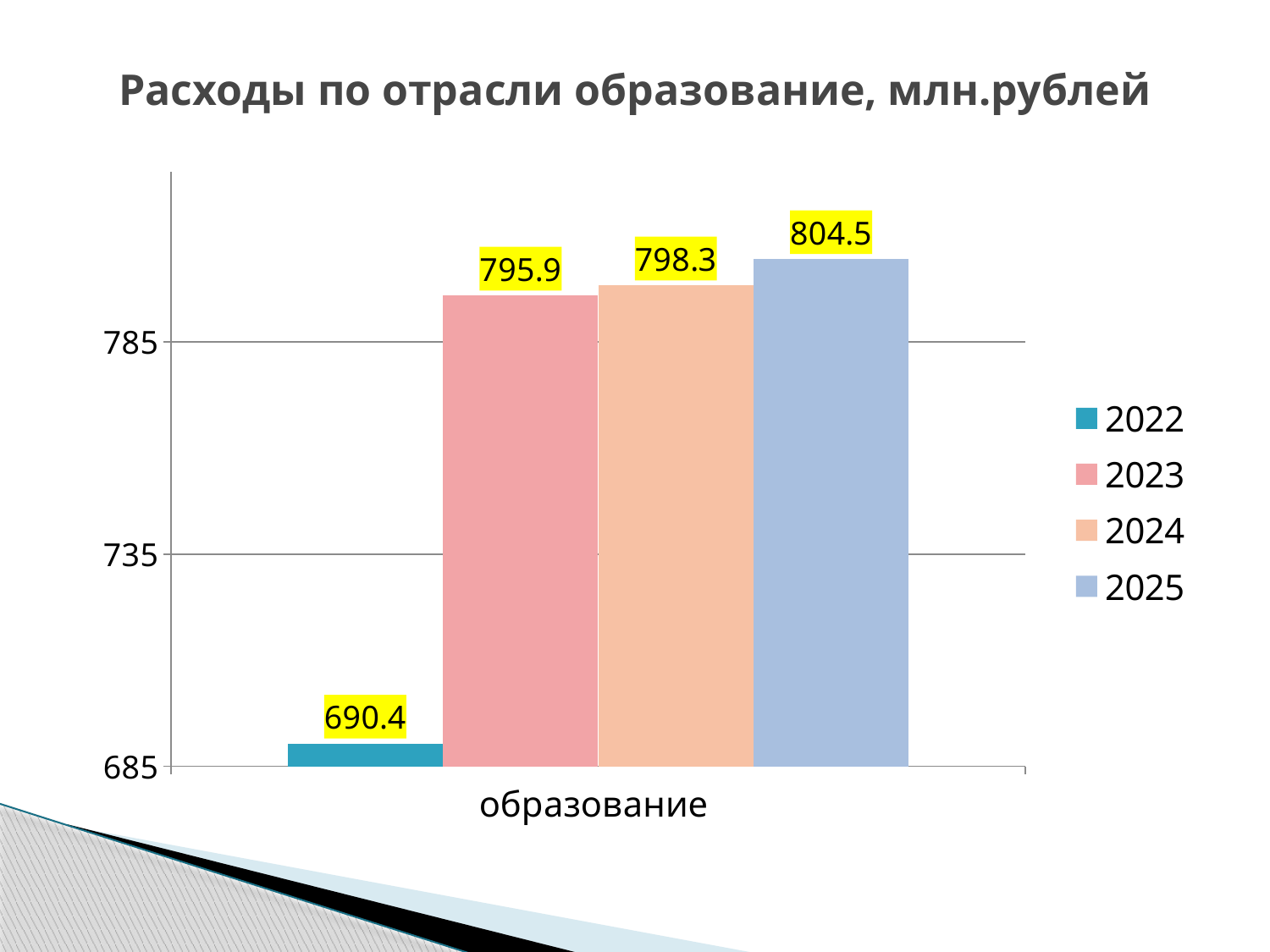
What is the difference between the values for 2024 and 2023? 2.4 How many series does the legend list? 4 What is the value for 2025 in the chart? 804.5 Which year has the lowest value? 2022 Is the value for 2022 greater or less than 735? less What is the value for 2022 in the chart? 690.4 Which is larger, the value for 2023 or the value for 2022? 2023 Which year has the highest value? 2025 What kind of chart is shown on the slide? bar chart What is the value for 2023 in the chart? 795.9 What is the difference between the values for 2025 and 2022? 114.1 What is the value for 2024 in the chart? 798.3